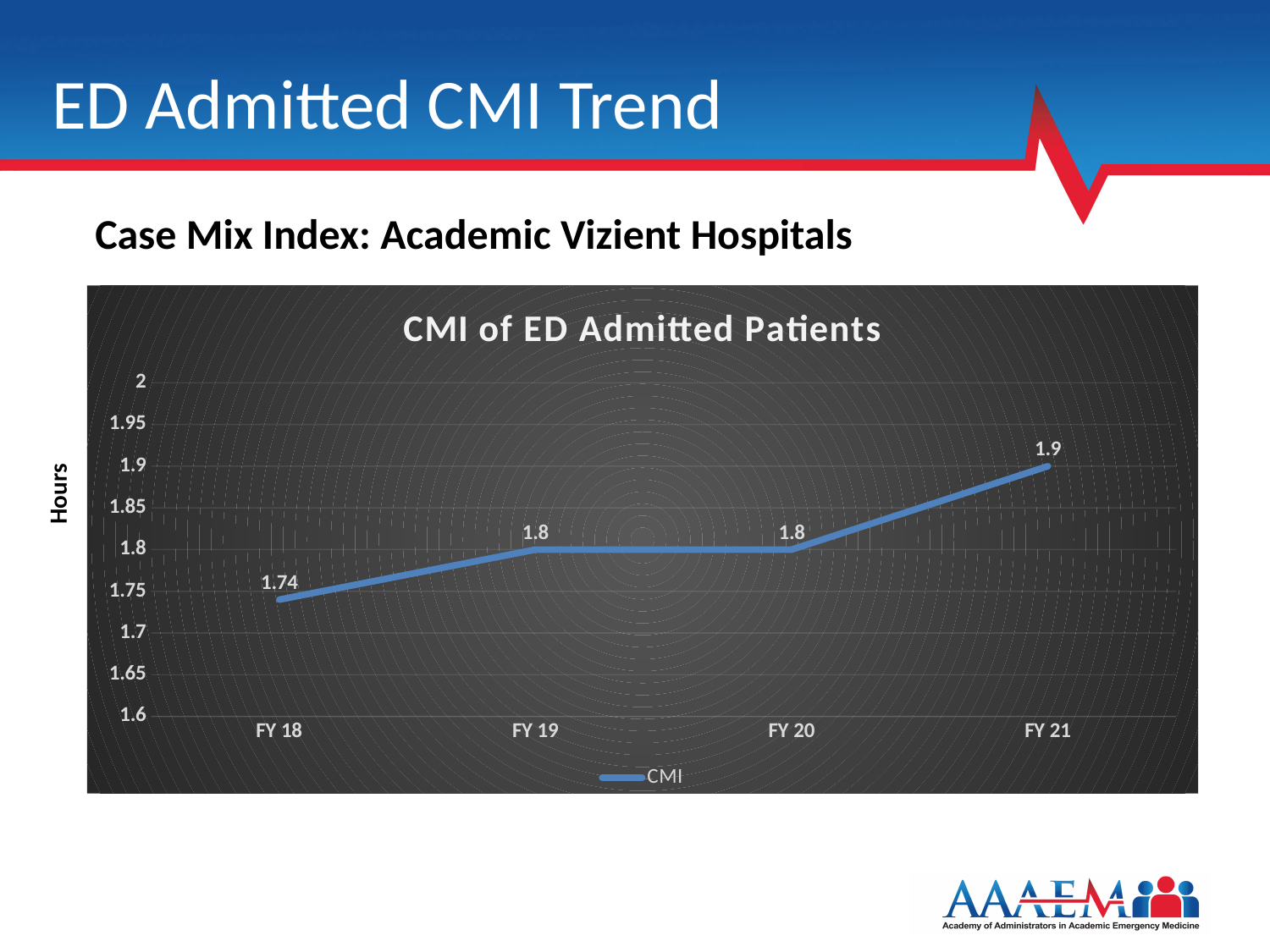
How many series does the legend list? 1 How many fiscal years are plotted on the chart? 4 What is the difference between the CMI values for FY 21 and FY 18? 0.16 Which is larger, the CMI value for FY 18 or for FY 20? FY 20 Which fiscal year has the lowest CMI value? FY 18 What is the CMI value for FY 18? 1.74 What is the title of the chart? CMI of ED Admitted Patients What is the difference between the CMI values for FY 21 and FY 20? 0.1 Which fiscal year has the highest CMI value? FY 21 What kind of chart is shown on the slide? Line chart What is the CMI value for FY 19? 1.8 What is the CMI value for FY 21? 1.9